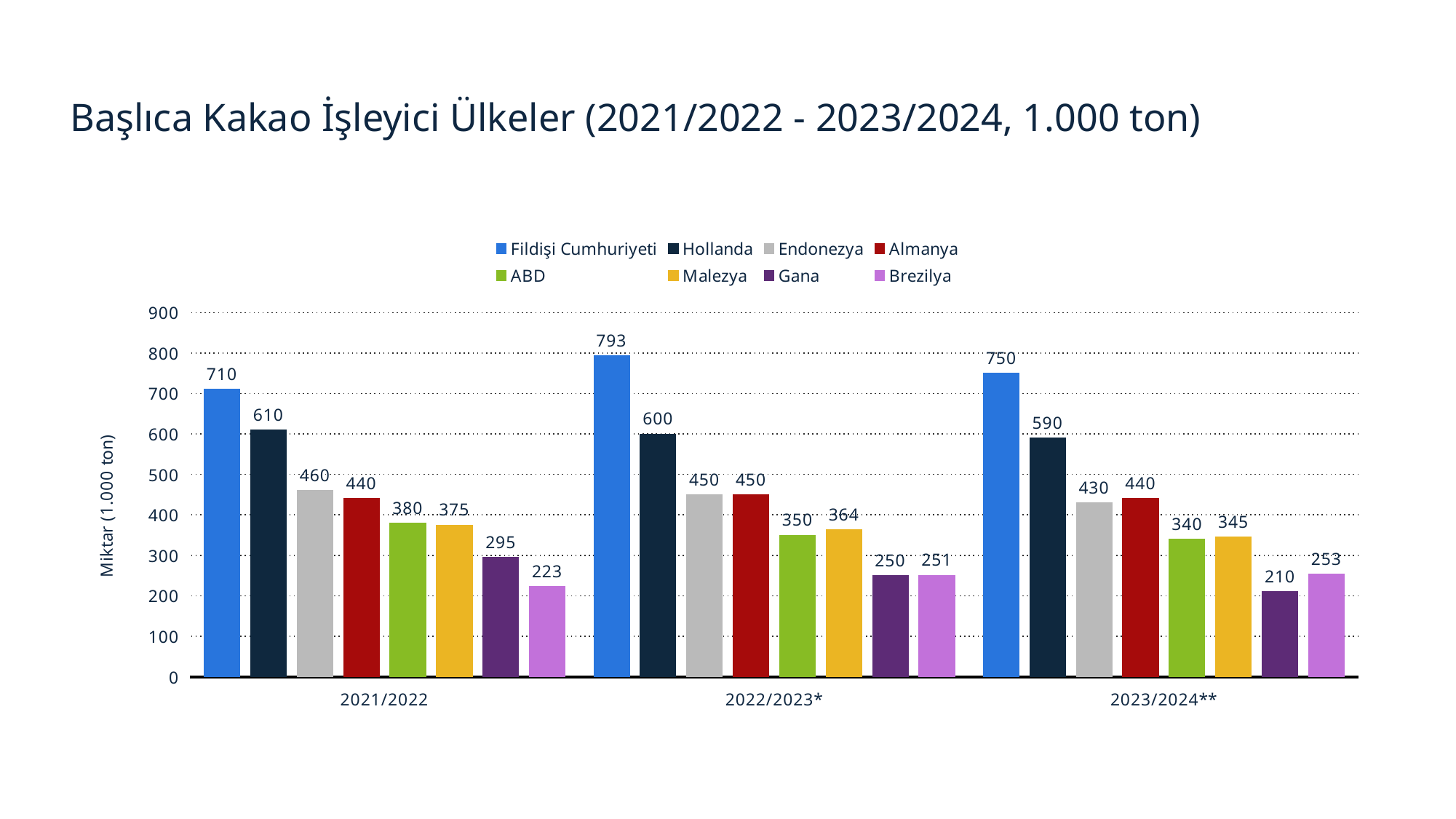
What is the value for Malezya in 2022/2023*? 364 What is the y-axis label of the chart? Miktar (1.000 ton) Which is larger in 2021/2022: Endonezya or Almanya? Endonezya What is the value for Hollanda in 2023/2024**? 590 What is the value for Brezilya in 2021/2022? 223 How many categories are shown on the x axis? 3 Which series has the lowest value in 2023/2024**? Gana What kind of chart is shown on the slide? Bar chart Which series has the highest value in 2021/2022? Fildişi Cumhuriyeti What is the value for Fildişi Cumhuriyeti in 2022/2023*? 793 What is the difference between Fildişi Cumhuriyeti and Hollanda in 2022/2023*? 193 How many series does the legend list? 8